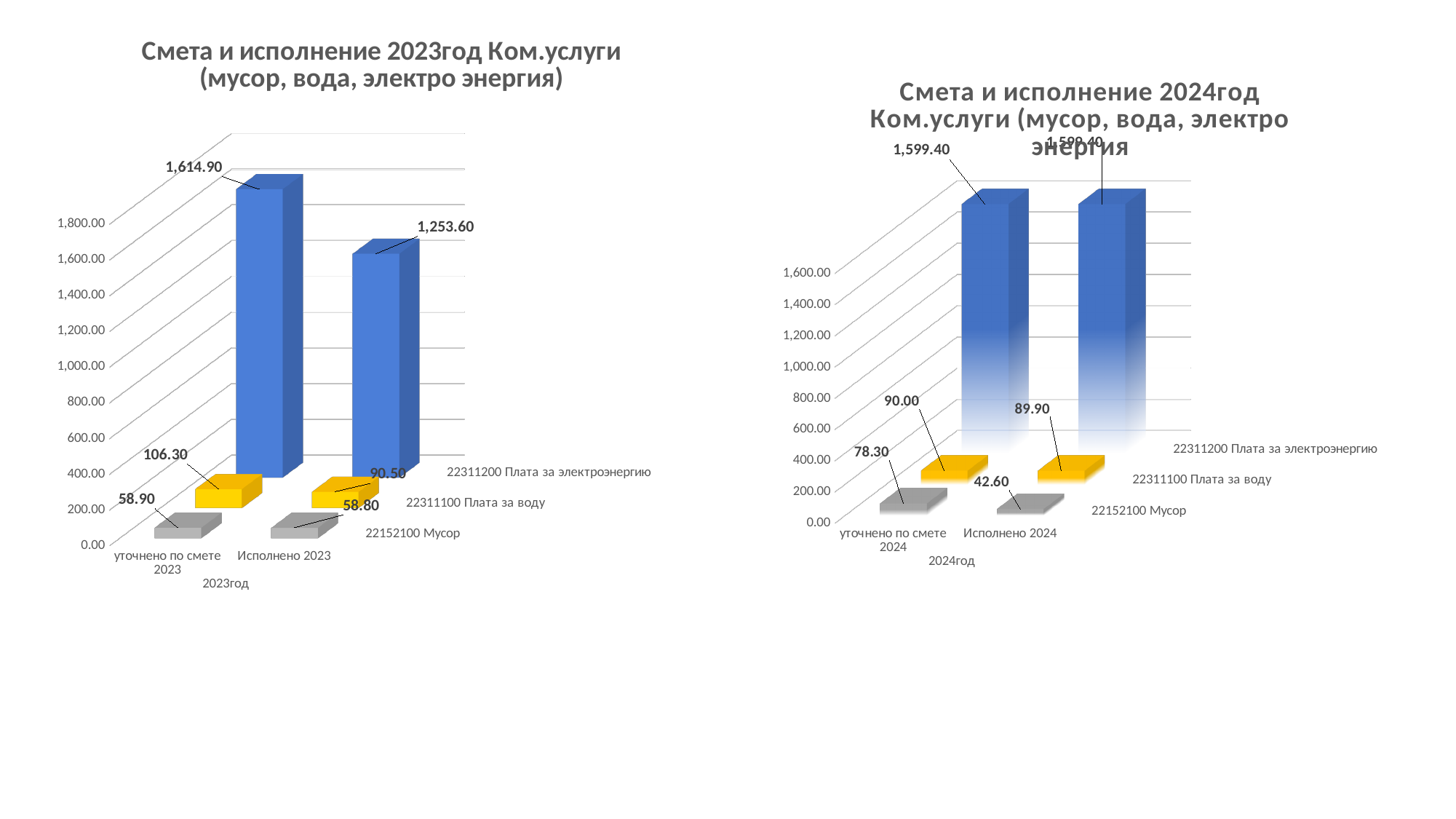
In the right chart (Смета и исполнение 2024год), what is the value for 22311100 Плата за воду under Исполнено 2024? 89.90 In the left chart (Смета и исполнение 2023год), what is the value for 22152100 Мусор under Исполнено 2023? 58.80 In the right chart (Смета и исполнение 2024год), what is the value for 22152100 Мусор under Исполнено 2024? 42.60 What kind of chart is the right chart (Смета и исполнение 2024год)? Bar chart How many series does the left chart (Смета и исполнение 2023год) show? 3 In the left chart (Смета и исполнение 2023год), what is the value for 22311200 Плата за электроэнергию under Исполнено 2023? 1,253.60 In the right chart (Смета и исполнение 2024год), what is the difference between the уточнено по смете 2024 and Исполнено 2024 values for 22152100 Мусор? 35.70 In the left chart (Смета и исполнение 2023год), which is larger for 22311100 Плата за воду: уточнено по смете 2023 or Исполнено 2023? уточнено по смете 2023 In the left chart (Смета и исполнение 2023год), what is the value for 22311100 Плата за воду under уточнено по смете 2023? 106.30 In the left chart (Смета и исполнение 2023год), what is the value for 22311200 Плата за электроэнергию under уточнено по смете 2023? 1,614.90 In the left chart (Смета и исполнение 2023год), what is the difference between the уточнено по смете 2023 and Исполнено 2023 values for 22311200 Плата за электроэнергию? 361.30 In the right chart (Смета и исполнение 2024год), what is the value for 22152100 Мусор under уточнено по смете 2024? 78.30